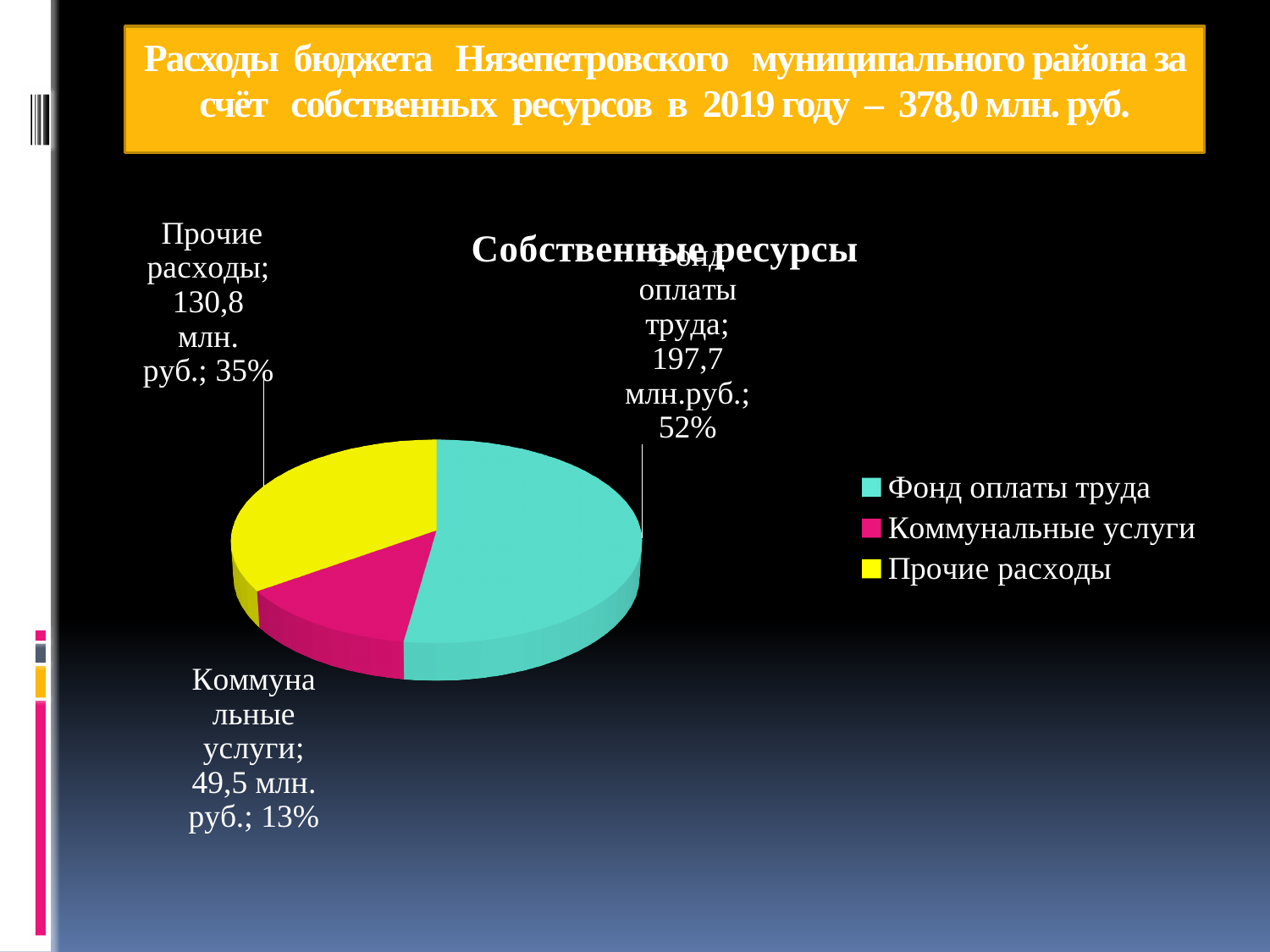
Which category has the largest slice? Фонд оплаты труда What is the value for Коммунальные услуги? 49,5 млн. руб. What type of chart is shown on the slide? pie chart Which is larger, Прочие расходы or Коммунальные услуги? Прочие расходы How many entries does the legend list? 3 What is the value for Прочие расходы? 130,8 млн. руб. What is the value for Фонд оплаты труда? 197,7 млн.руб. Which category has the smallest slice? Коммунальные услуги How many slices does the pie chart have? 3 What share of the pie does Прочие расходы represent? 35% What share of the pie does Фонд оплаты труда represent? 52% What is the title of the chart? Собственные ресурсы